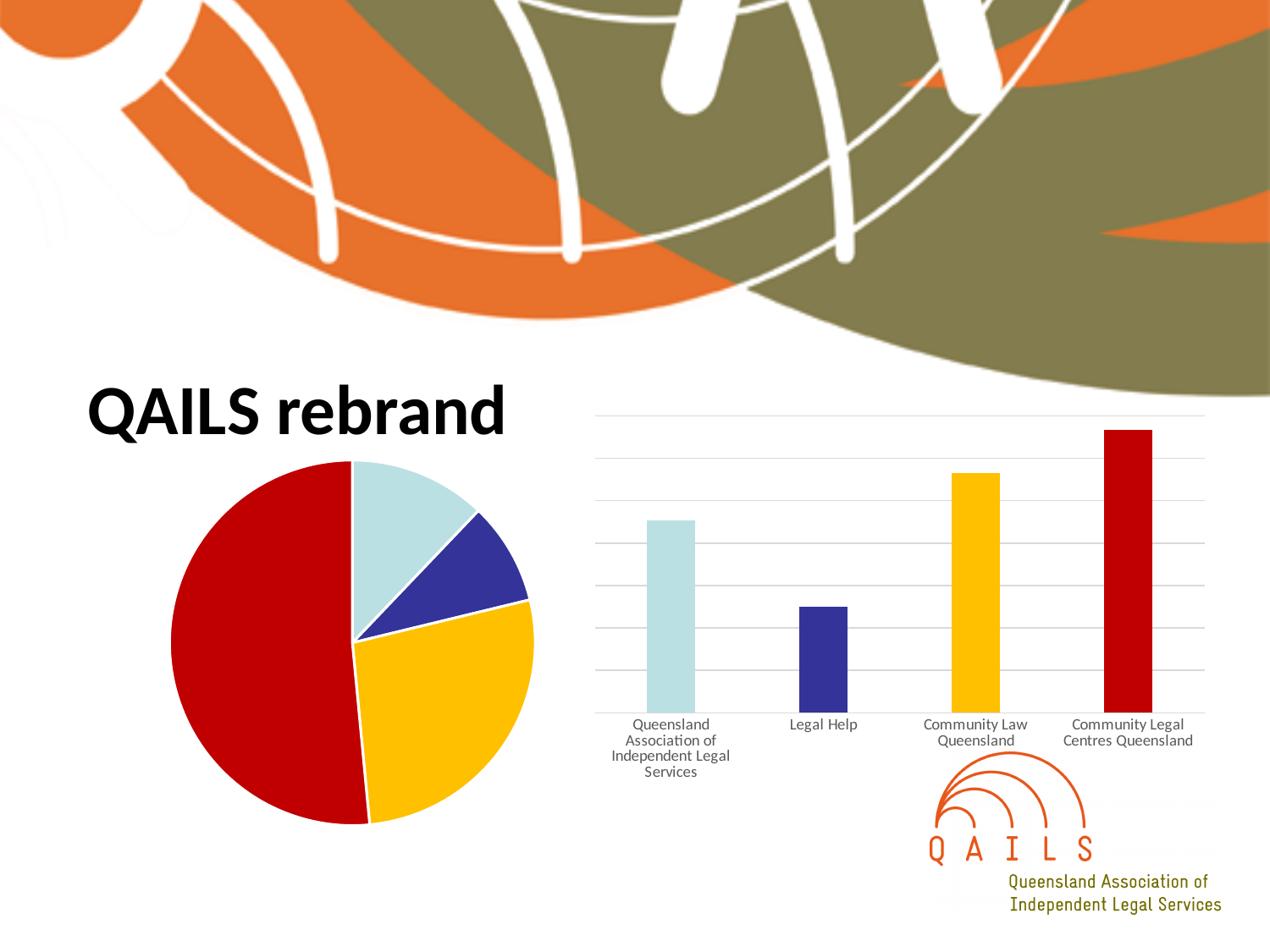
In the bar chart on the right, which category has the highest value? Community Legal Centres Queensland In the bar chart on the right, which is larger: Queensland Association of Independent Legal Services or Legal Help? Queensland Association of Independent Legal Services In the bar chart on the right, which is larger: Community Legal Centres Queensland or Community Law Queensland? Community Legal Centres Queensland In the pie chart on the left, how many slices are there? 4 What kind of chart is shown on the right side of the slide? Bar chart In the bar chart on the right, how many categories are shown? 4 In the bar chart on the right, do the values rise or fall from Legal Help through to Community Legal Centres Queensland? Rise What is the title text shown on the slide? QAILS rebrand What kind of chart is shown on the left side of the slide, below the title? Pie chart In the bar chart on the right, what colour is the bar for Community Legal Centres Queensland? Red In the bar chart on the right, which is larger: Community Law Queensland or Queensland Association of Independent Legal Services? Community Law Queensland In the bar chart on the right, which category has the lowest value? Legal Help